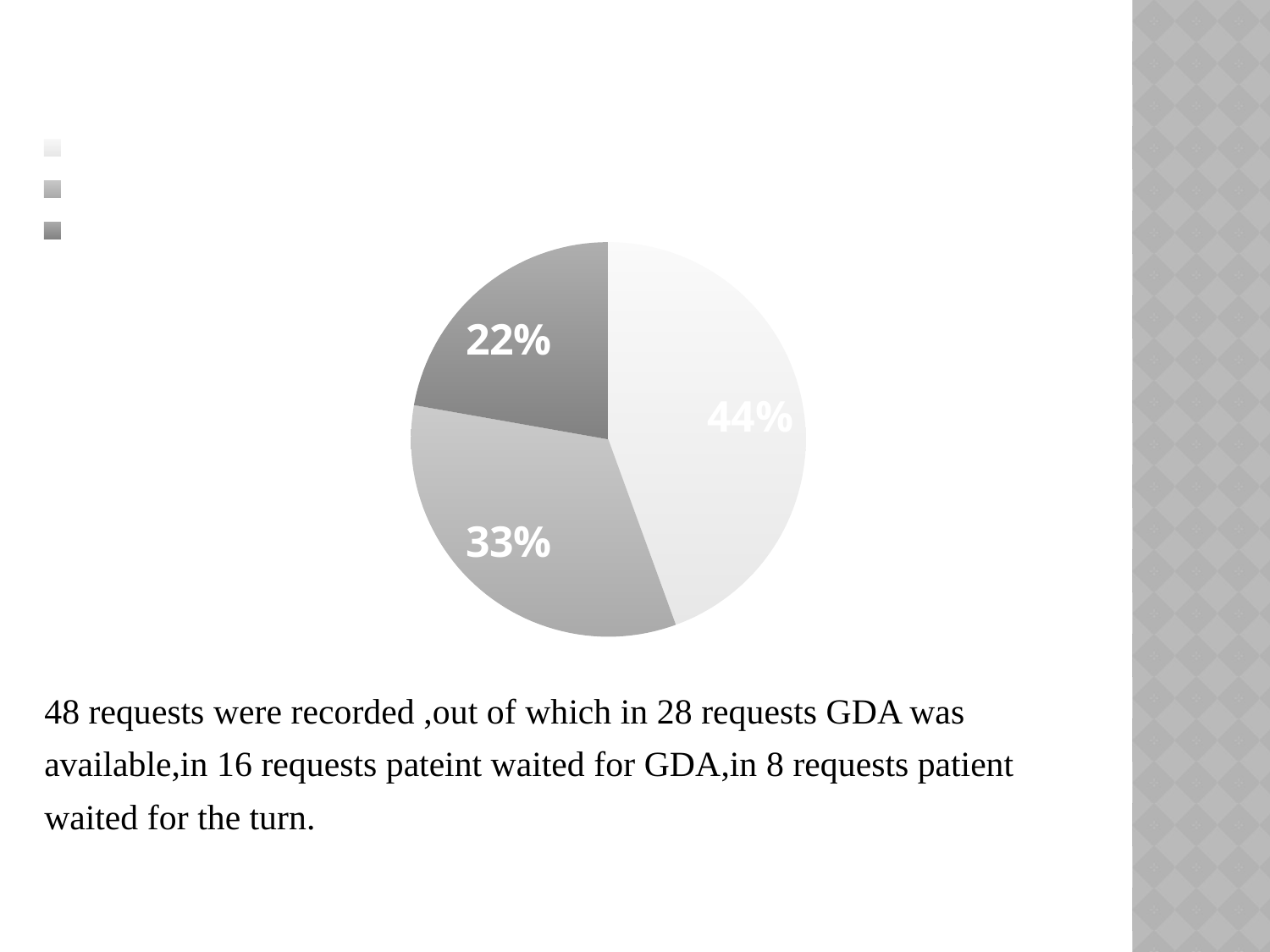
What is the percentage shown on the darkest slice of the pie chart? 22% How many legend entries are shown beside the pie chart? 3 What is the difference in percentage points between the largest and smallest slices of the pie chart? 22 What is the percentage shown on the smallest slice of the pie chart? 22% Which is larger, the darkest slice or the medium grey slice of the pie chart? the medium grey slice How many slices does the pie chart have? 3 What is the difference in percentage points between the 44% slice and the 33% slice? 11 What is the percentage shown on the medium grey slice of the pie chart? 33% What is the percentage shown on the lightest slice of the pie chart? 44% What kind of chart is shown on the slide? pie chart What is the percentage shown on the largest slice of the pie chart? 44% Is the largest slice of the pie chart greater or less than 40%? greater